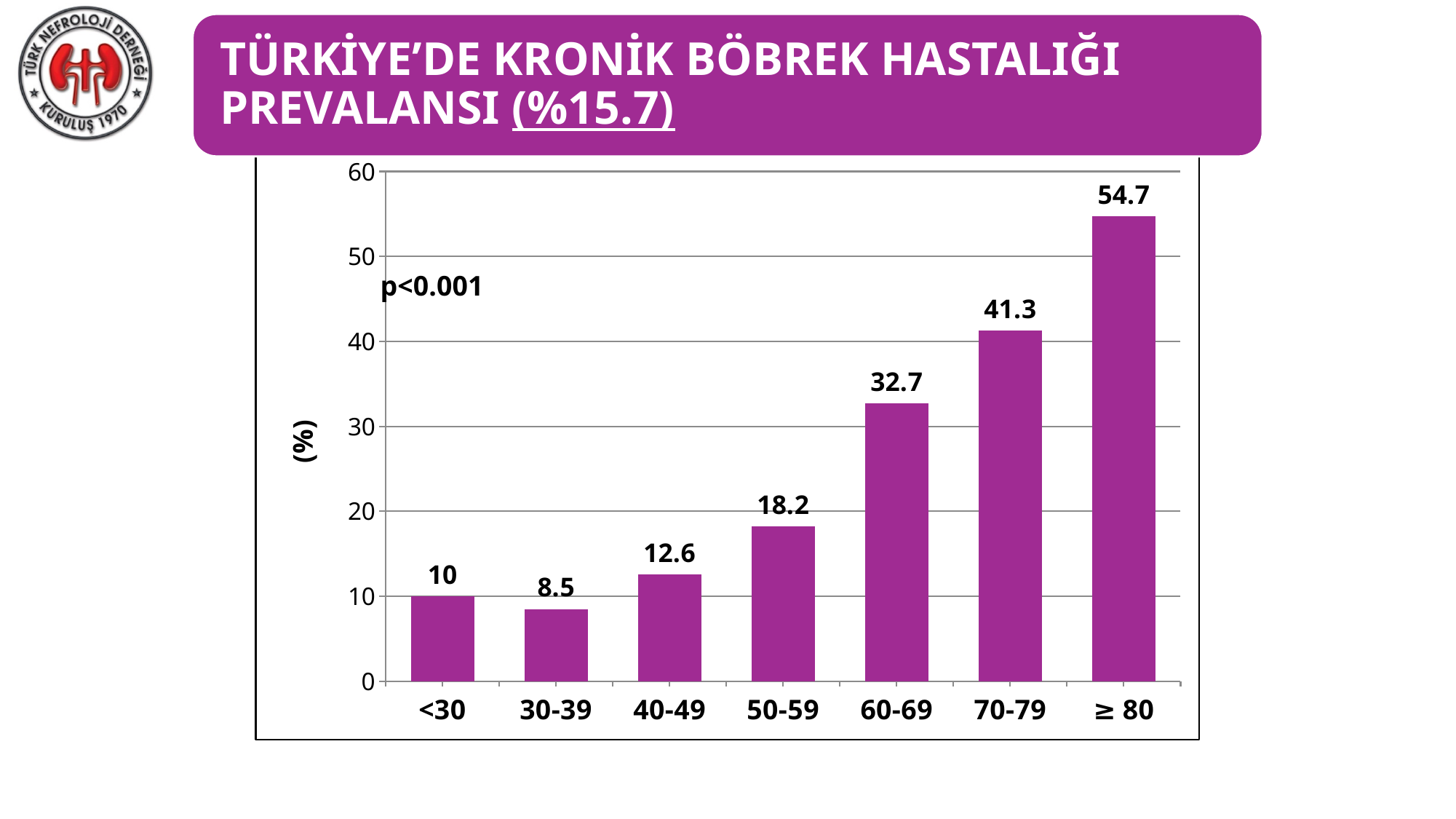
How many age groups are shown on the x axis? 7 What is the difference between the values for ≥ 80 and 70-79? 13.4 Which is larger, the value for 60-69 or the value for 70-79? 70-79 What is the p-value annotation shown on the chart? p<0.001 Which age group has the lowest value? 30-39 Is the value for 50-59 greater or less than 20? less What is the difference between the values for 50-59 and 30-39? 9.7 Which age group has the highest value? ≥ 80 What is the value for the 40-49 age group? 12.6 What kind of chart is shown on the slide? bar chart What is the value for the <30 age group? 10 What is the value for the 60-69 age group? 32.7